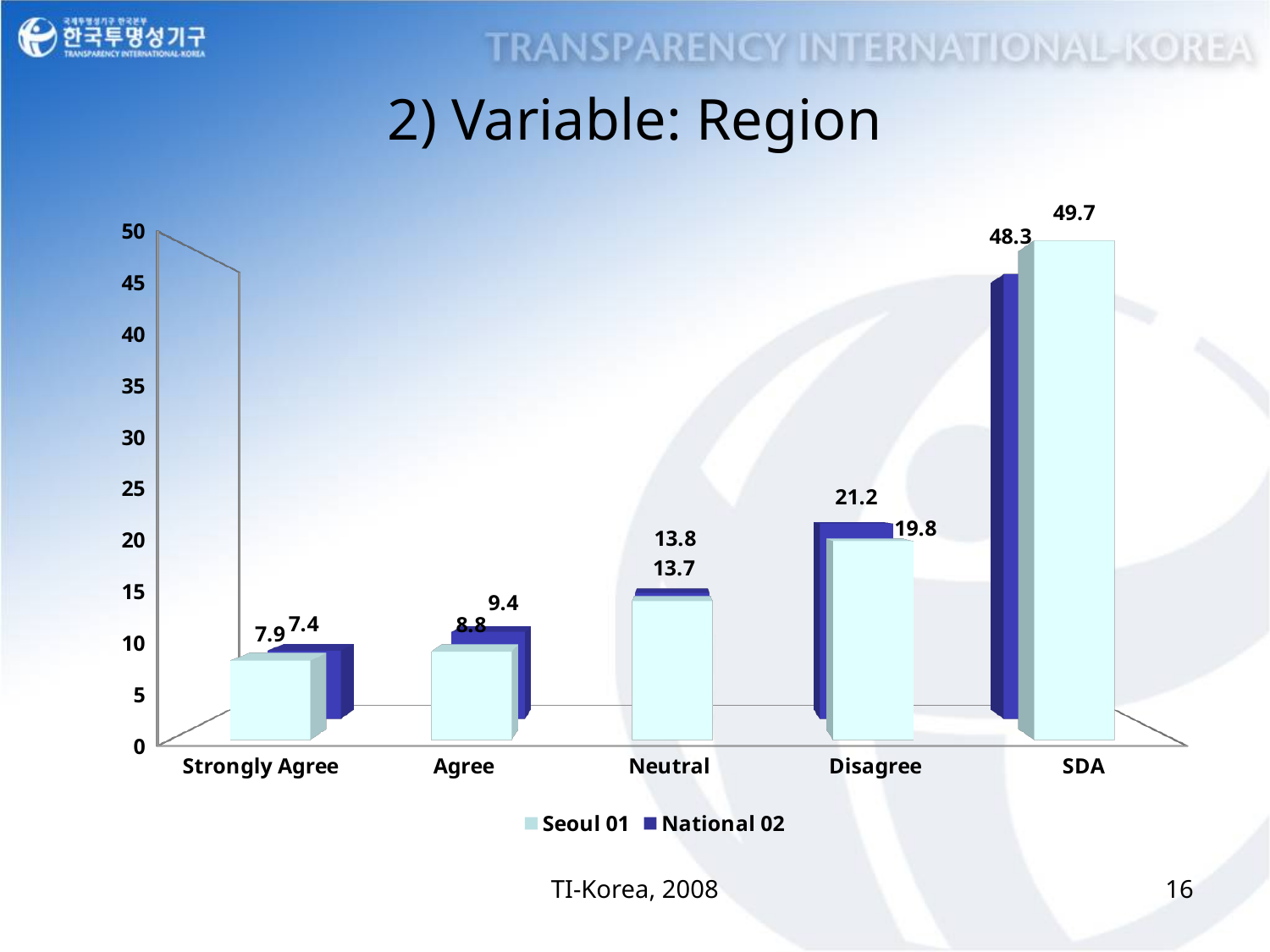
Do the values generally rise or fall moving from Strongly Agree to SDA along the x axis? Rise Are the values for Strongly Agree greater or less than 10? less Are the values for SDA greater or less than 45? greater What is the lowest value labelled on the chart? 7.4 How many series does the chart's legend list? 2 Which category has the lowest values in the chart? Strongly Agree What are the two series named in the legend? Seoul 01 and National 02 Which category has the highest values in the chart? SDA How many categories are shown on the x axis of the chart? 5 Which category has larger values, Disagree or Neutral? Disagree What kind of chart is shown on the slide? Bar chart What is the highest value labelled on the chart? 49.7